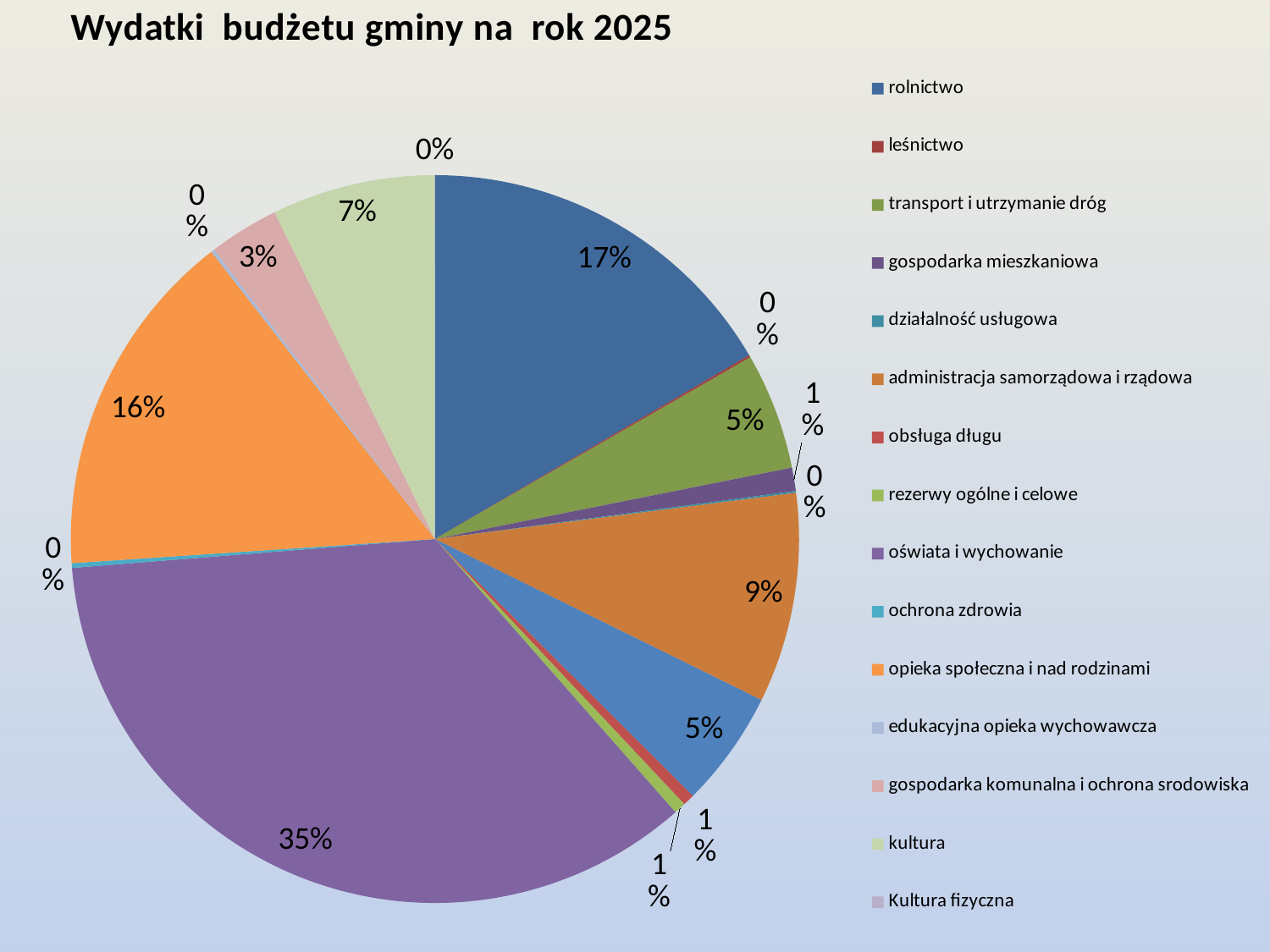
What share of the budget goes to kultura? 7% Which category has the largest share of the pie? oświata i wychowanie What share of the budget goes to opieka społeczna i nad rodzinami? 16% What share of the budget goes to oświata i wychowanie? 35% What is the title of the chart? Wydatki budżetu gminy na rok 2025 What kind of chart is shown on the slide? pie chart Which is larger, the share for rolnictwo or the share for opieka społeczna i nad rodzinami? rolnictwo By how many percentage points does the share for oświata i wychowanie exceed the share for rolnictwo? 18 How many categories does the legend list? 15